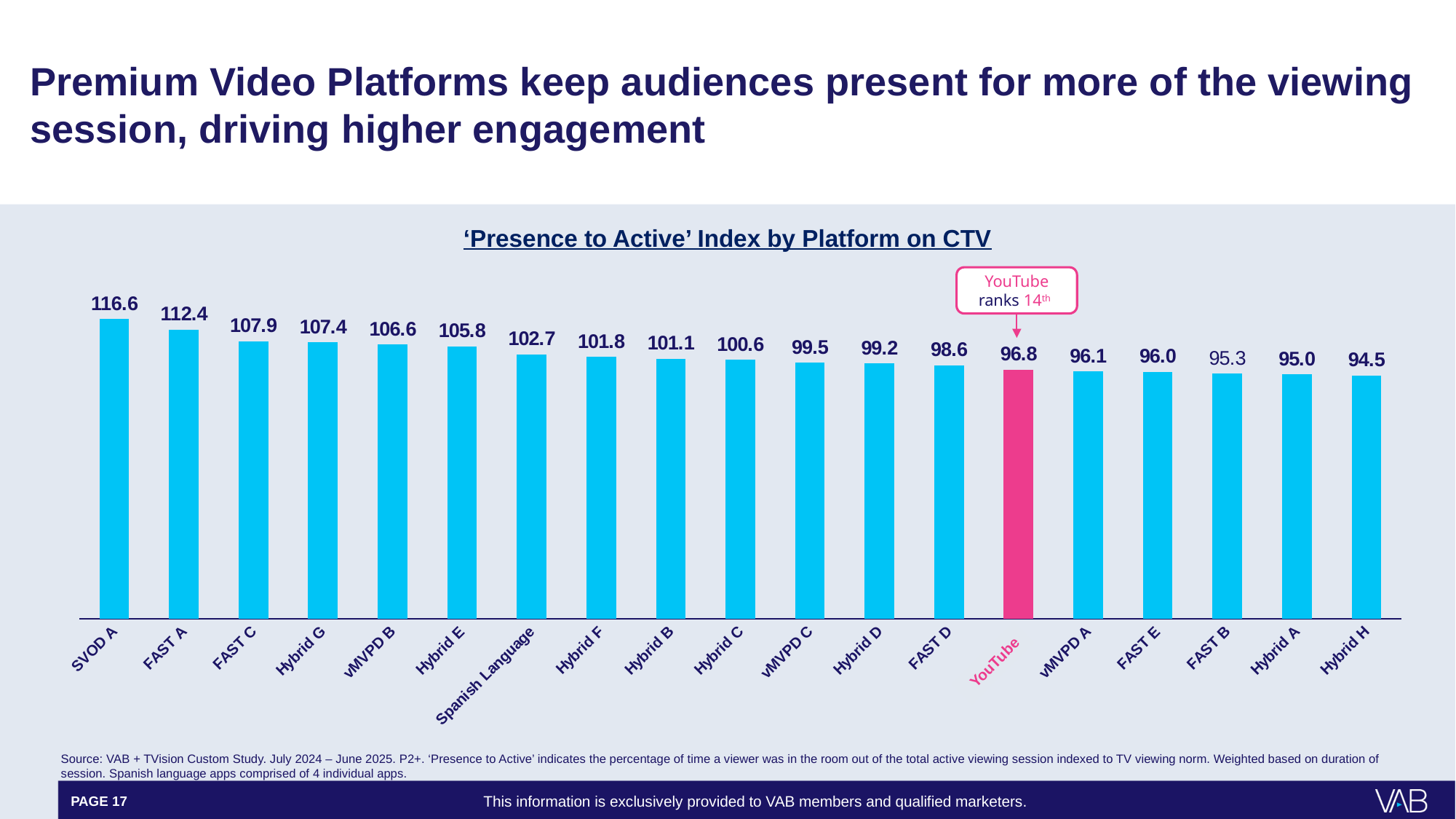
How many platforms are shown in the chart? 19 According to the callout on the chart, what rank does YouTube hold? 14th Which platform has the highest 'Presence to Active' index? SVOD A What is the 'Presence to Active' index value for YouTube? 96.8 What is the difference between the index values for YouTube and Hybrid H? 2.3 Do the index values rise or fall moving from left to right across the chart? Fall What is the difference between the index values for SVOD A and FAST A? 4.2 What is the index value for Spanish Language? 102.7 Which platform has the lowest 'Presence to Active' index? Hybrid H What is the index value for vMVPD B? 106.6 What type of chart is used on this slide? Bar chart Which has a higher index value, Hybrid G or Hybrid E? Hybrid G